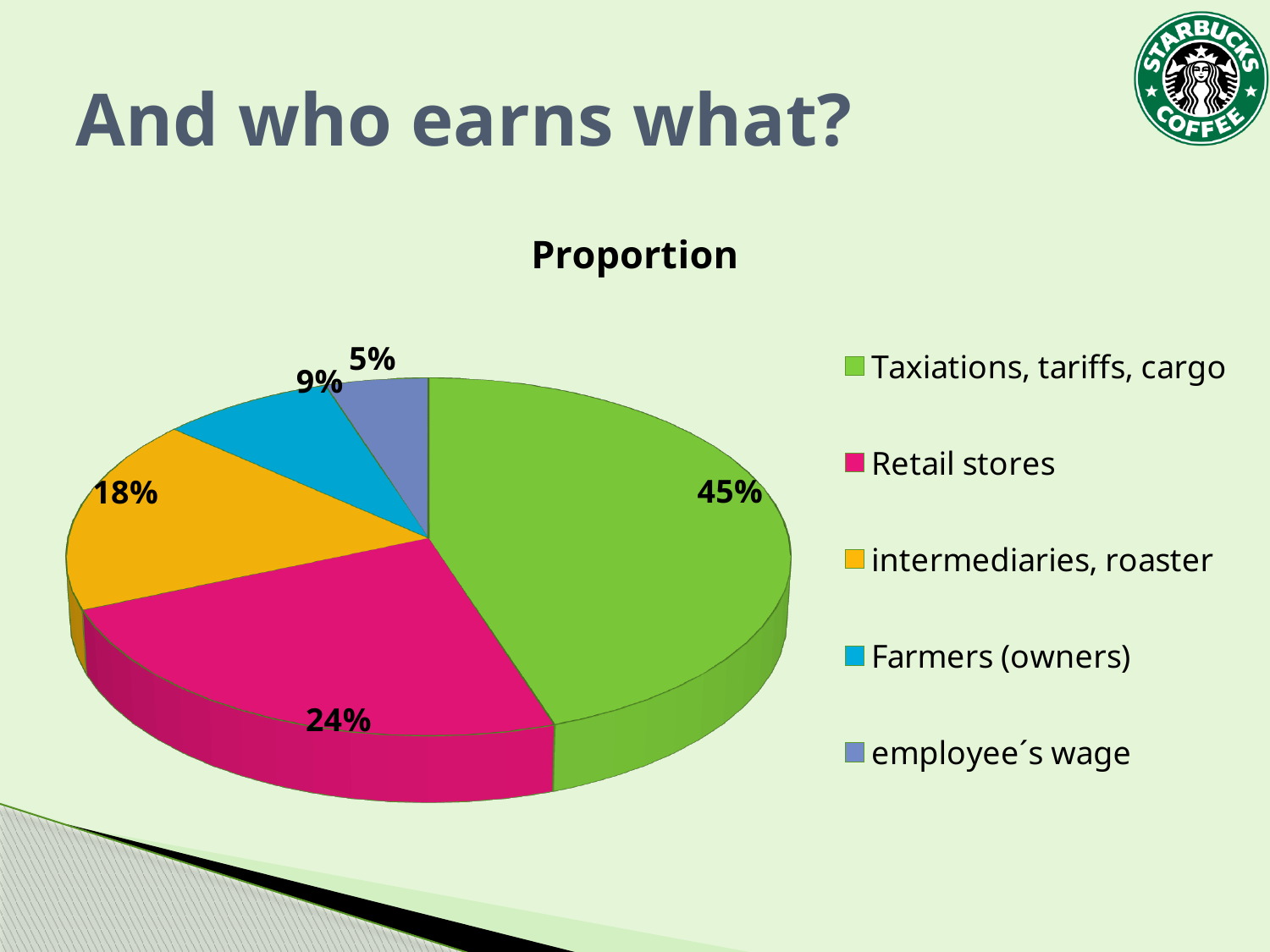
Which category has the largest slice of the pie? Taxiations, tariffs, cargo Which is larger, the share for intermediaries, roaster or the share for Retail stores? Retail stores What share of the pie goes to Taxiations, tariffs, cargo? 45% What share of the pie goes to intermediaries, roaster? 18% What share of the pie goes to Farmers (owners)? 9% How many categories does the pie chart show? 5 What is the difference between the shares for Retail stores and Farmers (owners)? 15% What kind of chart is shown on the slide? Pie chart Which category has the smallest slice of the pie? employee´s wage What is the chart's title? Proportion